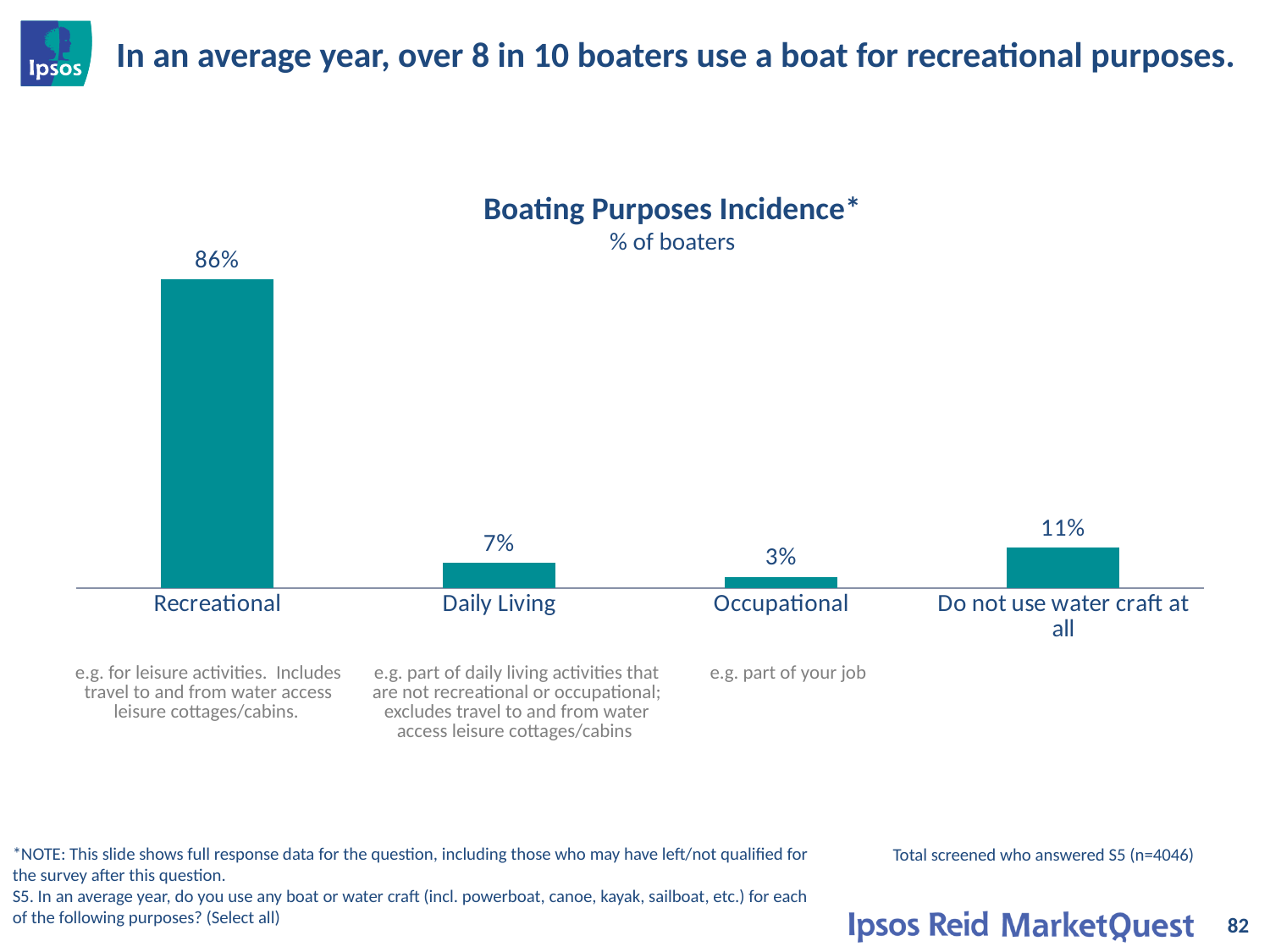
Which category has the lowest value? Occupational Which category has the highest value? Recreational What percentage of boaters do not use water craft at all? 11% What is the value for Occupational? 3% What percentage of boaters use a boat for Recreational purposes? 86% What is the value for Daily Living? 7% What is the difference between the Recreational and Daily Living values? 79% What is the difference between the 'Do not use water craft at all' and Occupational values? 8% Which is larger, the value for Daily Living or the value for Do not use water craft at all? Do not use water craft at all What is the title of the chart? Boating Purposes Incidence* What type of chart is shown on the slide? Bar chart How many categories are shown in the chart? 4